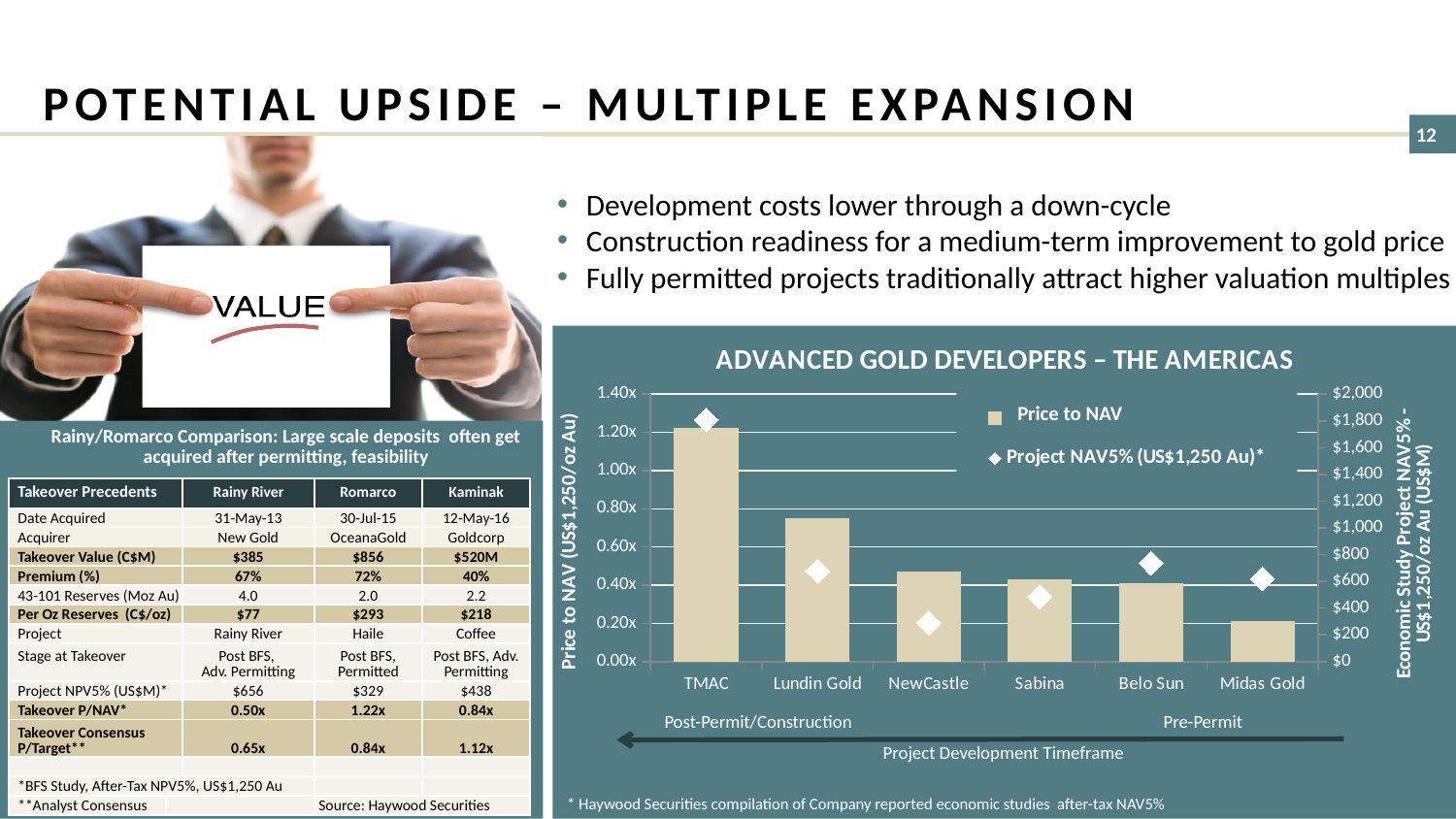
In the 'Advanced Gold Developers – The Americas' chart, is the Price to NAV bar for TMAC greater or less than 1.00x? greater What is the title of the chart on the right side of the slide? ADVANCED GOLD DEVELOPERS – THE AMERICAS How many series does the legend of the 'Advanced Gold Developers – The Americas' chart list? 2 In the 'Advanced Gold Developers – The Americas' chart, is the Price to NAV bar for Midas Gold greater or less than 0.40x? less How many companies are shown on the x axis of the 'Advanced Gold Developers – The Americas' chart? 6 In the 'Advanced Gold Developers – The Americas' chart, which has the larger Price to NAV bar, TMAC or Lundin Gold? TMAC In the 'Advanced Gold Developers – The Americas' chart, which company has the lowest Price to NAV bar? Midas Gold In the 'Advanced Gold Developers – The Americas' chart, which company has the highest Price to NAV bar? TMAC In the 'Advanced Gold Developers – The Americas' chart, do the Price to NAV bars rise or fall from left to right along the x axis? fall What type of chart is used in the 'Advanced Gold Developers – The Americas' chart? bar chart In the 'Advanced Gold Developers – The Americas' chart, is the Project NAV5% marker for TMAC greater or less than $1,600? greater